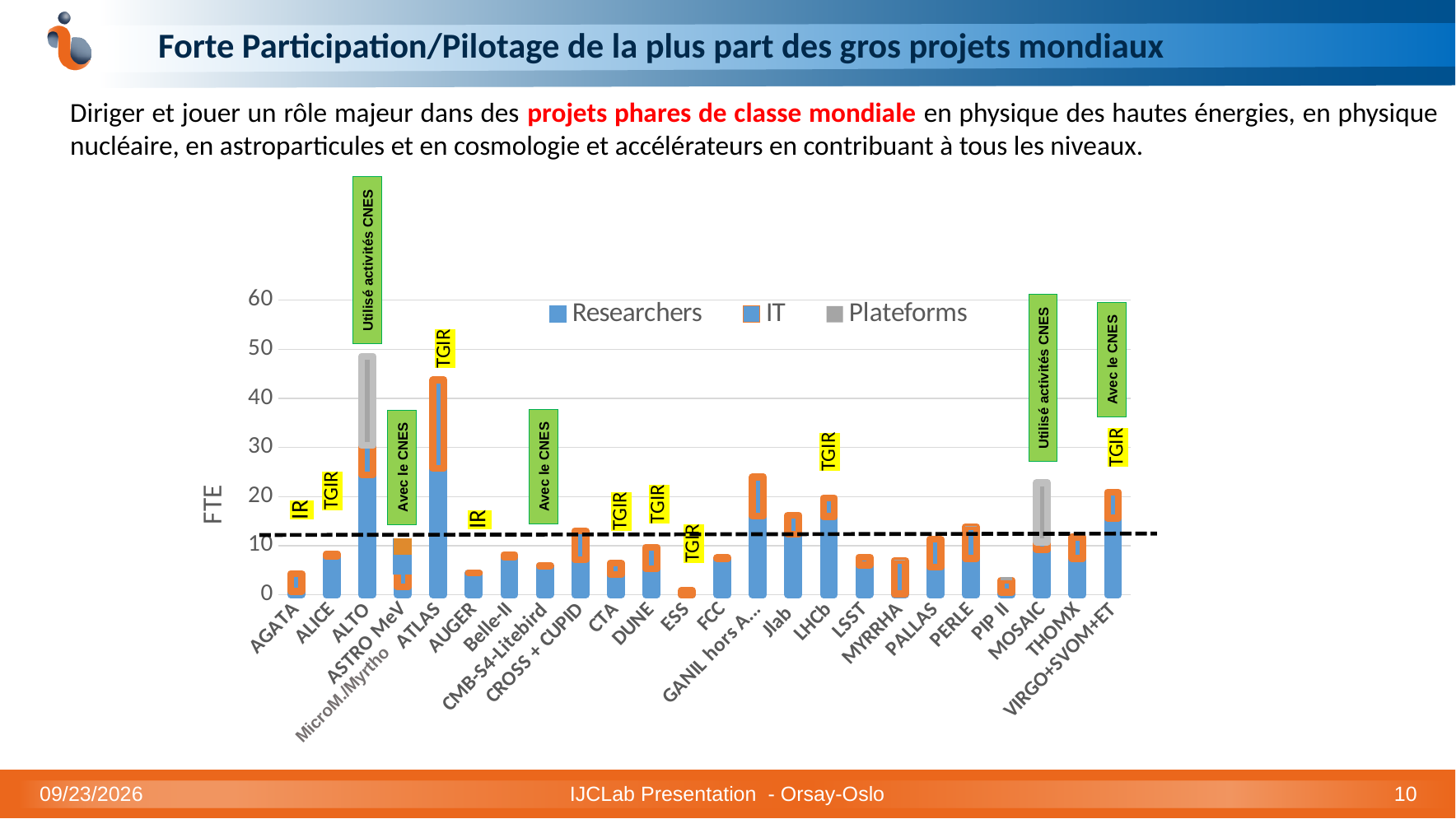
Is the total value for PIP II greater or less than 10? less Which bar is taller, LHCb or LSST? LHCb Which project has the tallest bar in the chart? ALTO What kind of chart is shown on the slide? bar chart Which bar is taller, ALTO or ATLAS? ALTO What is the label on the vertical axis of the chart? FTE Which project has the shortest bar in the chart? ESS What are the series names listed in the chart legend? Researchers, IT, Plateforms How many series does the chart legend list? 3 Is the total value for ESS greater or less than 10? less Is the total value for GANIL hors A... greater or less than 20? greater